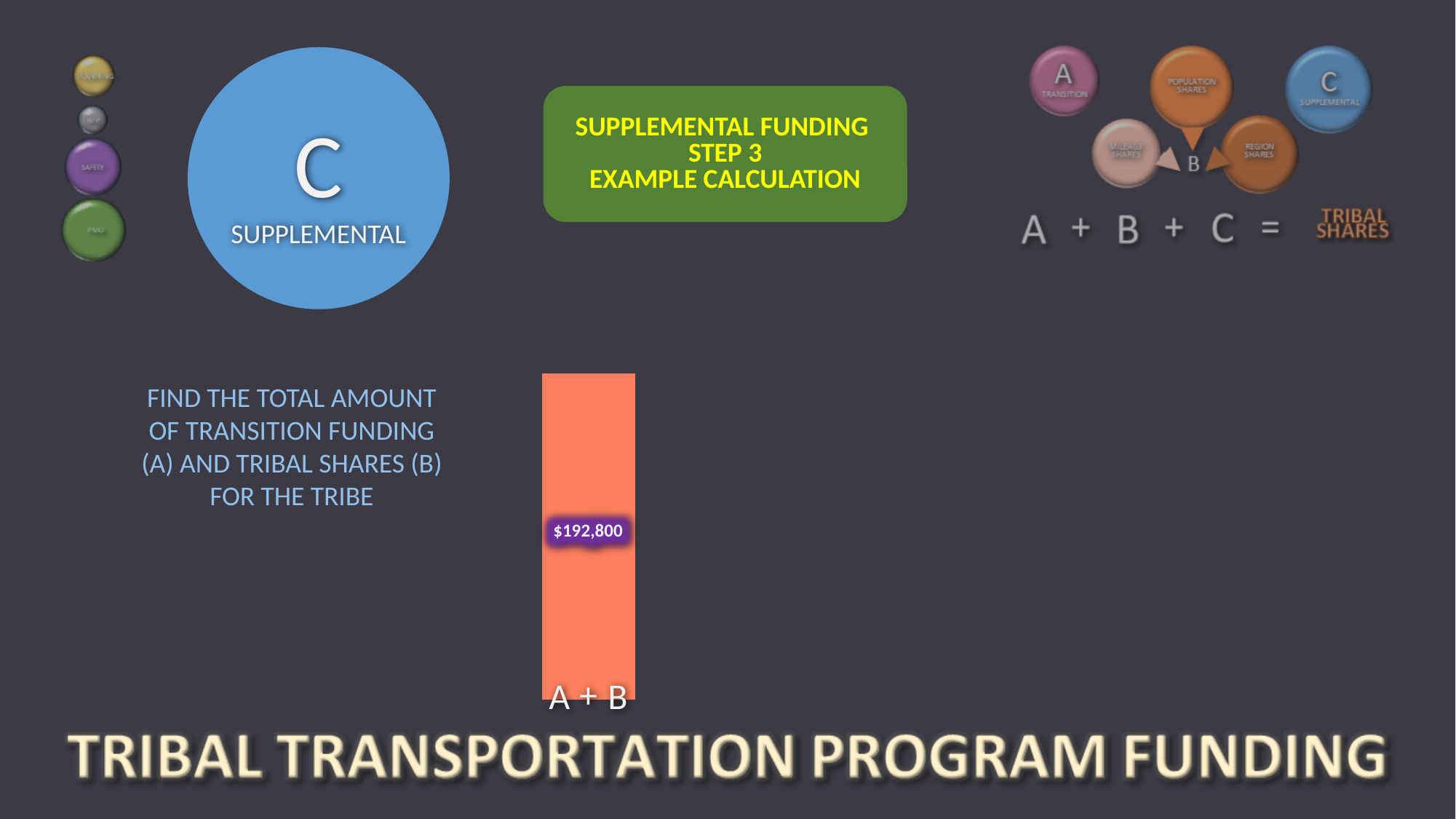
What is the label of the single bar in the chart? A + B What is the value shown for the A + B bar? $192,800 Is the value for A + B greater or less than $100,000? greater What kind of chart is shown on the slide? bar chart What colour is the A + B bar? orange How many bars does the chart show? 1